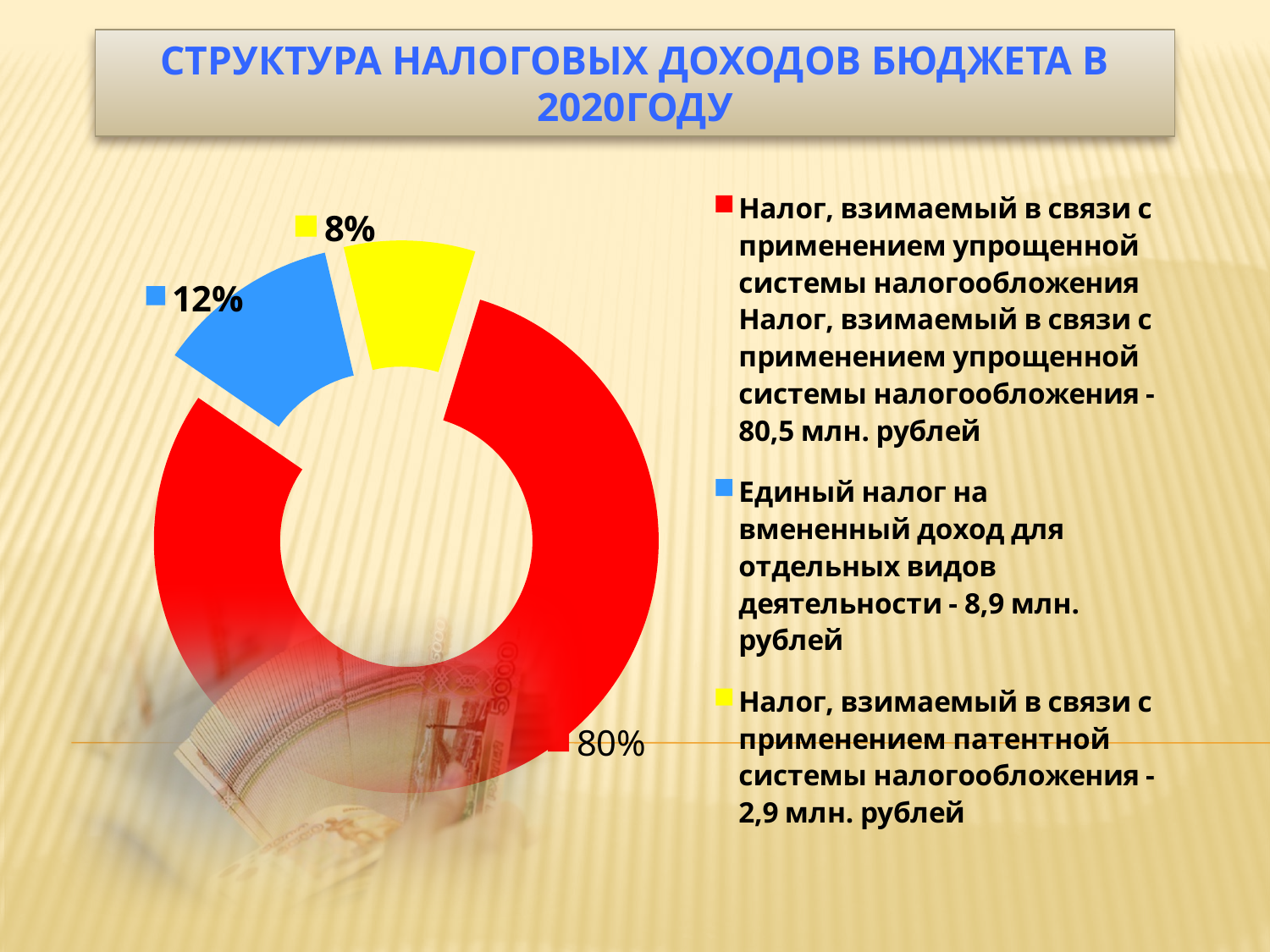
What share does the unified tax on imputed income for certain types of activity (blue slice) have in the chart? 12% What percentage of tax revenues does the tax levied under the simplified taxation system (red slice) account for? 80% What type of chart is shown on the slide? Doughnut (pie) chart How many entries does the legend list? 3 What is the difference between the blue slice (12%) and the yellow slice (8%)? 4 percentage points By how many percentage points does the simplified taxation system share exceed the unified tax on imputed income share? 68 percentage points Which category has the largest share of tax revenues in the chart? Налог, взимаемый в связи с применением упрощенной системы налогообложения Which category has the smallest share in the chart? Налог, взимаемый в связи с применением патентной системы налогообложения What is the title of the slide containing the chart? СТРУКТУРА НАЛОГОВЫХ ДОХОДОВ БЮДЖЕТА В 2020ГОДУ What percentage is shown for the tax levied under the patent taxation system (yellow slice)? 8% How many slices does the chart contain? 3 Which is larger: the share of the unified tax on imputed income or the share of the patent taxation system? Единый налог на вмененный доход для отдельных видов деятельности